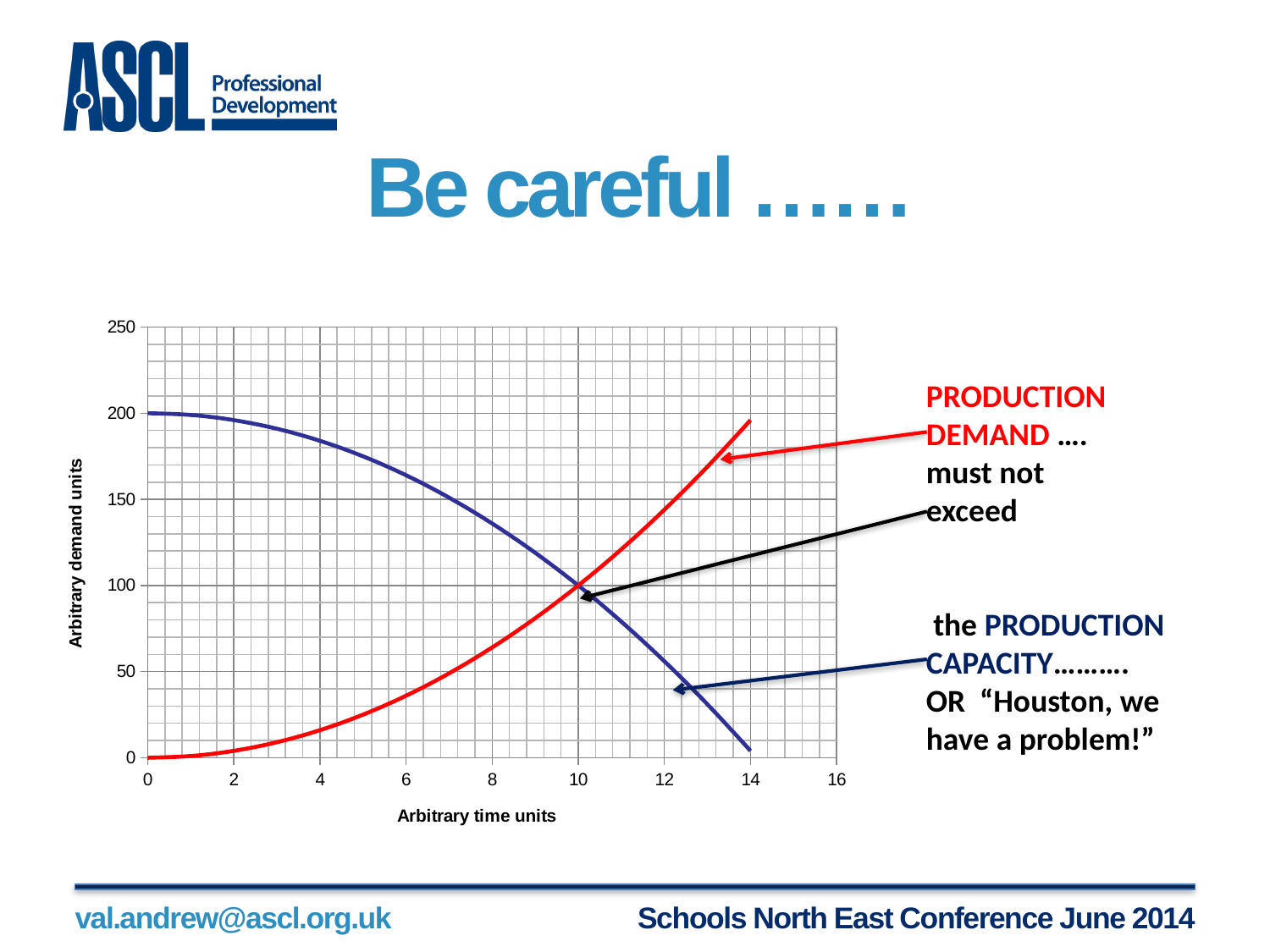
At time 4, which line is higher, the red line or the blue line? blue line Is the value of the blue line at time 4 greater or less than 150? greater At time 12, which line is higher, the red line or the blue line? red line Does the blue line (production capacity) rise or fall as time increases? falls Does the red line (production demand) rise or fall as time increases? rises Is the value of the red line at time 8 greater or less than 100? less What is the title of the vertical axis? Arbitrary demand units At what time do the red and blue lines cross? 10 What is the value of the blue line (production capacity) at time 0? 200 What is the value of the red line (production demand) at time 0? 0 How many lines are plotted on the chart? 2 What kind of chart is shown on the slide? line chart